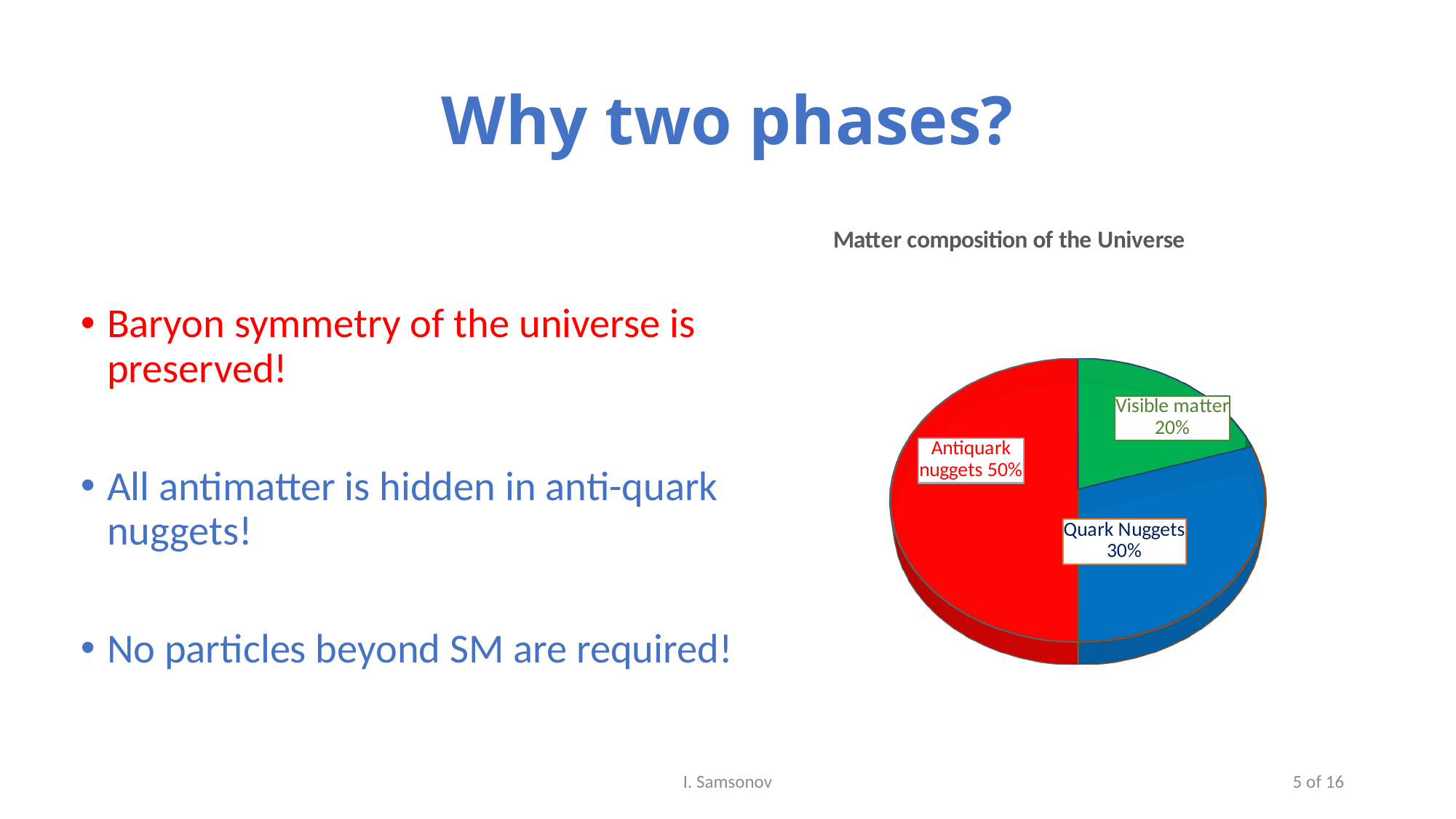
What share of the pie is Antiquark nuggets? 50% How many slices does the pie chart have? 3 What is the difference between the Quark Nuggets share and the Visible matter share? 10% What colour is the Visible matter slice? green What share of the pie is Visible matter? 20% Which slice of the pie is the smallest? Visible matter What kind of chart is shown on the slide? pie chart What is the difference between the Antiquark nuggets share and the Quark Nuggets share? 20% What share of the pie is Quark Nuggets? 30% Which slice of the pie is the largest? Antiquark nuggets What is the title of the chart? Matter composition of the Universe Which is larger, the Quark Nuggets slice or the Visible matter slice? Quark Nuggets